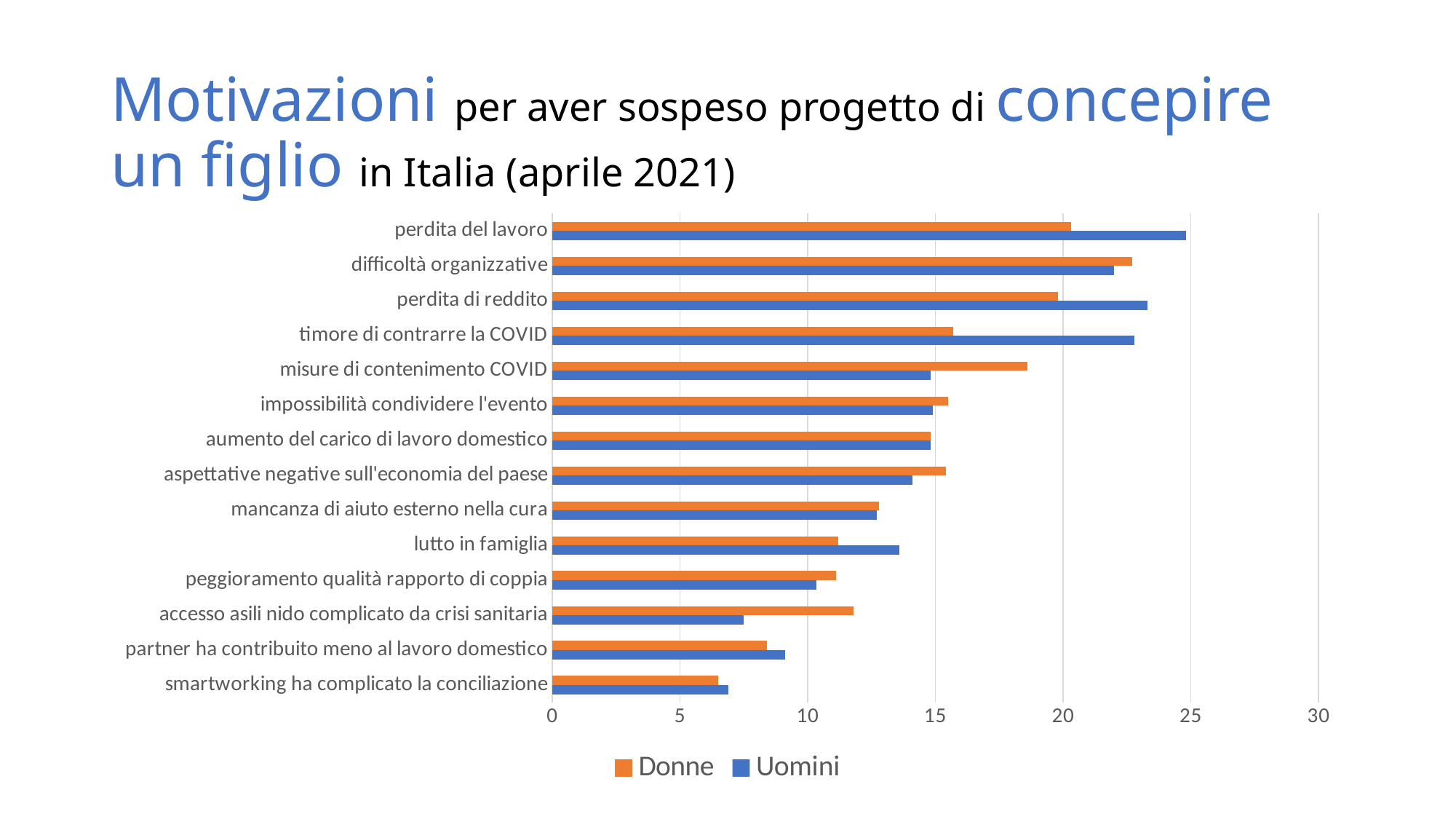
Which category has the lowest value for Donne? smartworking ha complicato la conciliazione Which category has the highest value for Donne? difficoltà organizzative Is the value for Uomini for 'accesso asili nido complicato da crisi sanitaria' greater or less than 10? less Is the value for Donne for 'accesso asili nido complicato da crisi sanitaria' greater or less than 10? greater How many series does the legend list? 2 For 'misure di contenimento COVID', which series has the larger value, Donne or Uomini? Donne Which colour represents the Donne series in the chart? orange Which category has the highest value for Uomini? perdita del lavoro For 'timore di contrarre la COVID', which series has the larger value, Donne or Uomini? Uomini What kind of chart is shown on the slide? bar chart How many categories (motivations) are plotted on the chart? 14 Is the value for Uomini for 'perdita del lavoro' greater or less than 20? greater